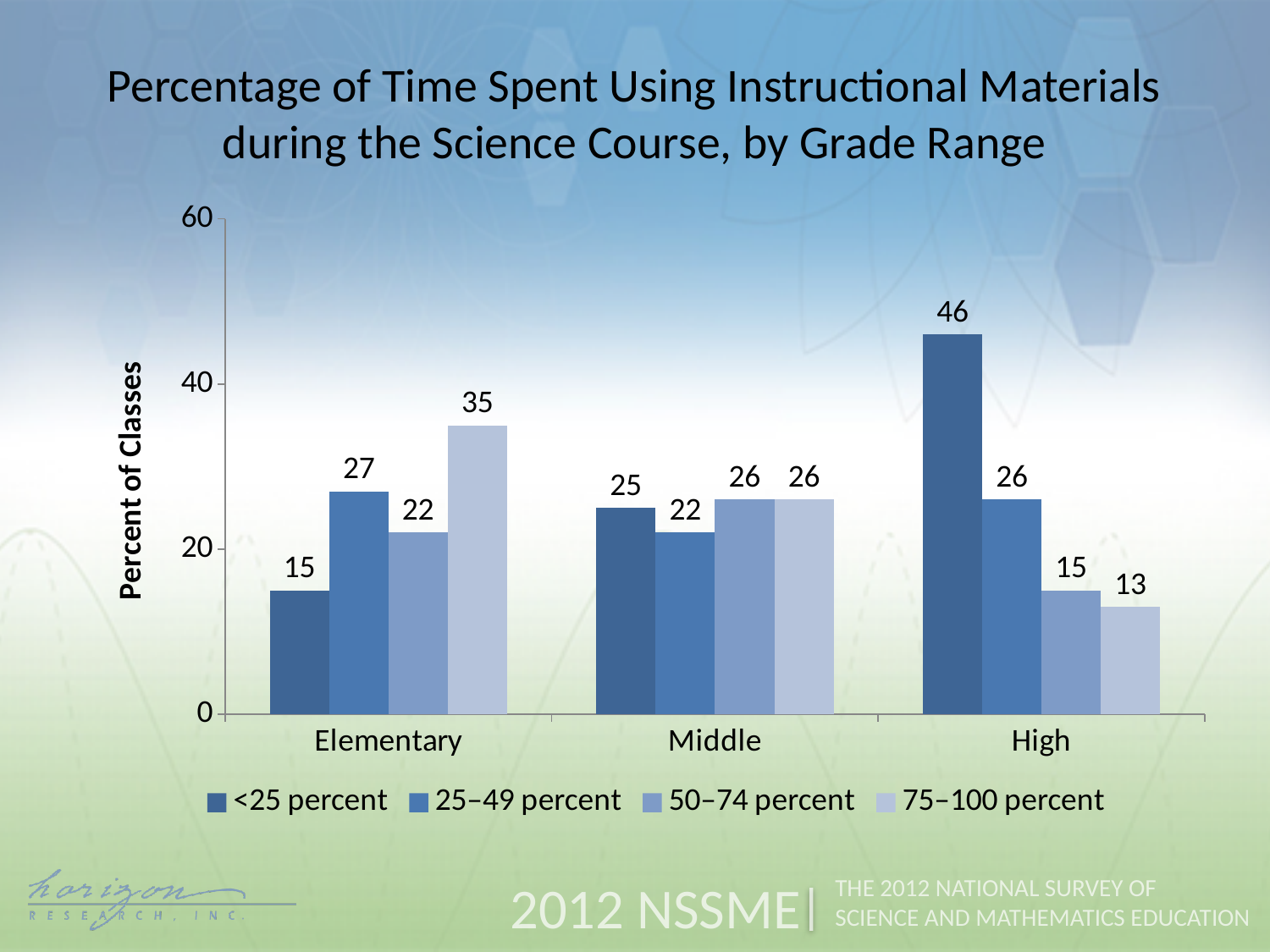
Is the value for the <25 percent series in the High grade range greater or less than 40? greater What is the value for the 75–100 percent series in the Elementary grade range? 35 Which grade range has the lowest value for the 75–100 percent series? High What is the value for the 25–49 percent series in the Middle grade range? 22 How many series does the legend list? 4 What is the label of the y axis? Percent of Classes Which grade range has the highest value for the <25 percent series? High What is the difference between the <25 percent value for High and the <25 percent value for Elementary? 31 What kind of chart is shown on the slide? bar chart What is the value for the <25 percent series in the High grade range? 46 Which is larger: the 75–100 percent value for Elementary or the 75–100 percent value for Middle? Elementary How many grade ranges are shown on the x axis? 3